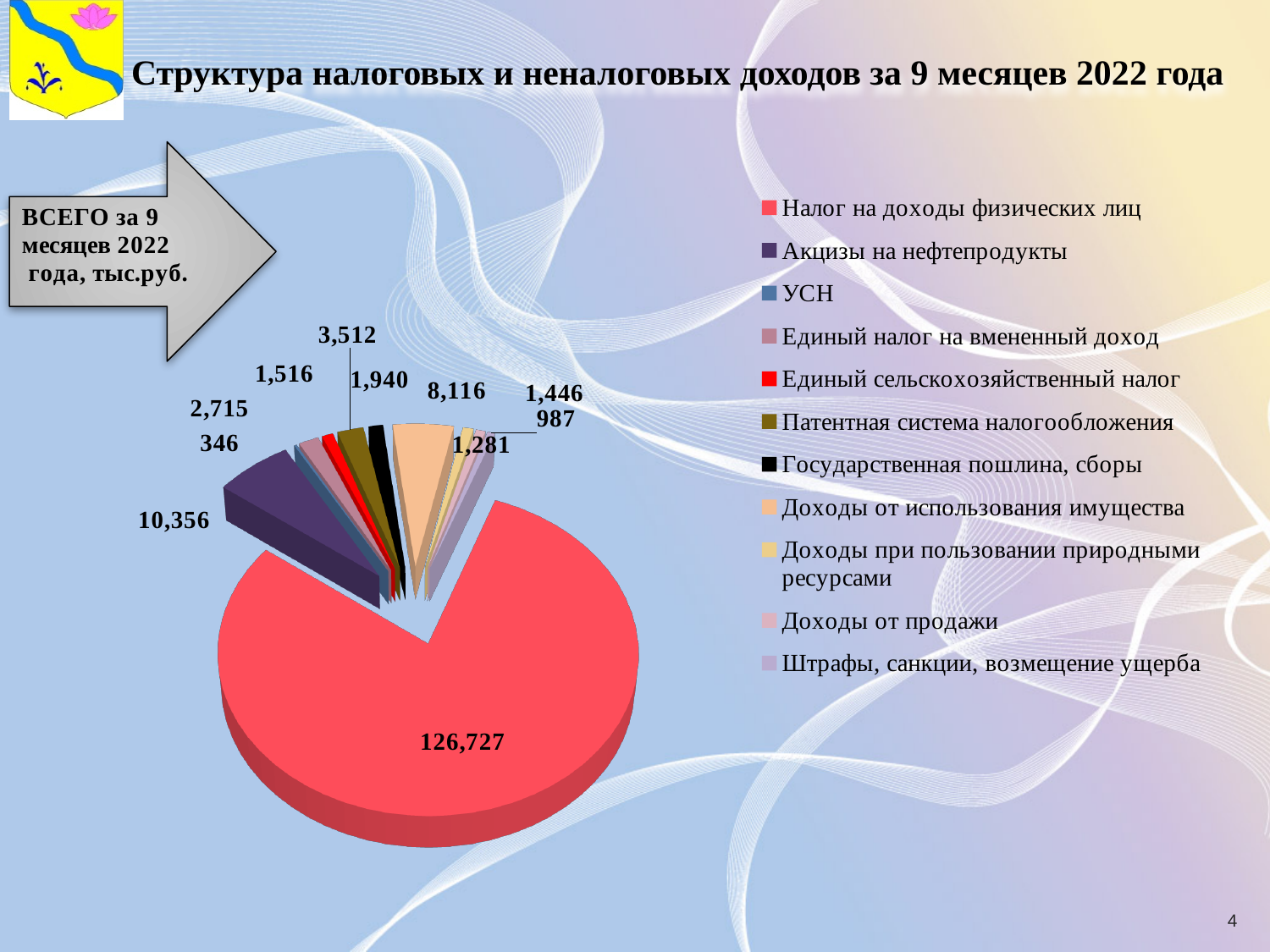
What is the value shown for Доходы от использования имущества? 8,116 What type of chart is shown on the slide? Pie chart What is the value shown for Акцизы на нефтепродукты? 10,356 How many categories does the legend list? 11 What is the value shown for Налог на доходы физических лиц? 126,727 What is the largest value labelled on the pie chart? 126,727 Which category has the largest slice of the pie? Налог на доходы физических лиц Which is larger: Акцизы на нефтепродукты or Доходы от использования имущества? Акцизы на нефтепродукты What is the difference between the values for Налог на доходы физических лиц and Акцизы на нефтепродукты? 116,371 What colour is the slice for Налог на доходы физических лиц? Coral (salmon red) What is the title of the slide's chart? Структура налоговых и неналоговых доходов за 9 месяцев 2022 года What is the smallest value labelled on the pie chart? 346